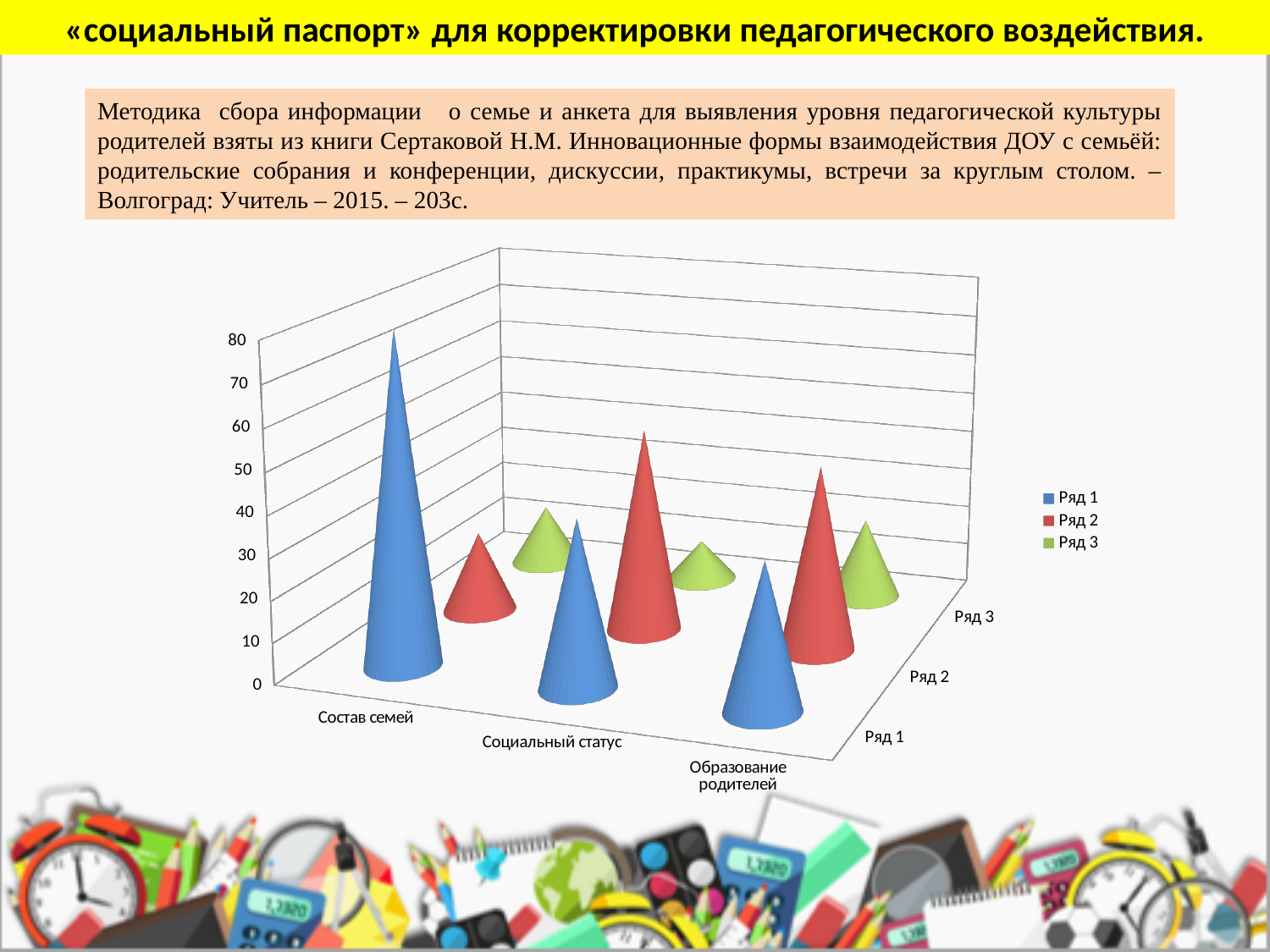
Which category has the lowest value for Ряд 1? Образование родителей Which is larger: the value of Ряд 1 for Состав семей or the value of Ряд 1 for Образование родителей? Состав семей What colour represents Ряд 3 in the chart's legend? green How many categories are shown on the chart's category axis? 3 How many series does the chart's legend list? 3 Which category has the lowest value for Ряд 2? Состав семей Is the value of Ряд 1 for Образование родителей greater or less than 50? less Is the value of Ряд 3 for Социальный статус greater or less than 50? less What kind of chart is shown on the slide? bar chart Is the value of Ряд 1 for Состав семей greater or less than 60? greater Which category has the highest value for Ряд 1? Состав семей Do the values of Ряд 1 rise or fall from Состав семей to Образование родителей? fall